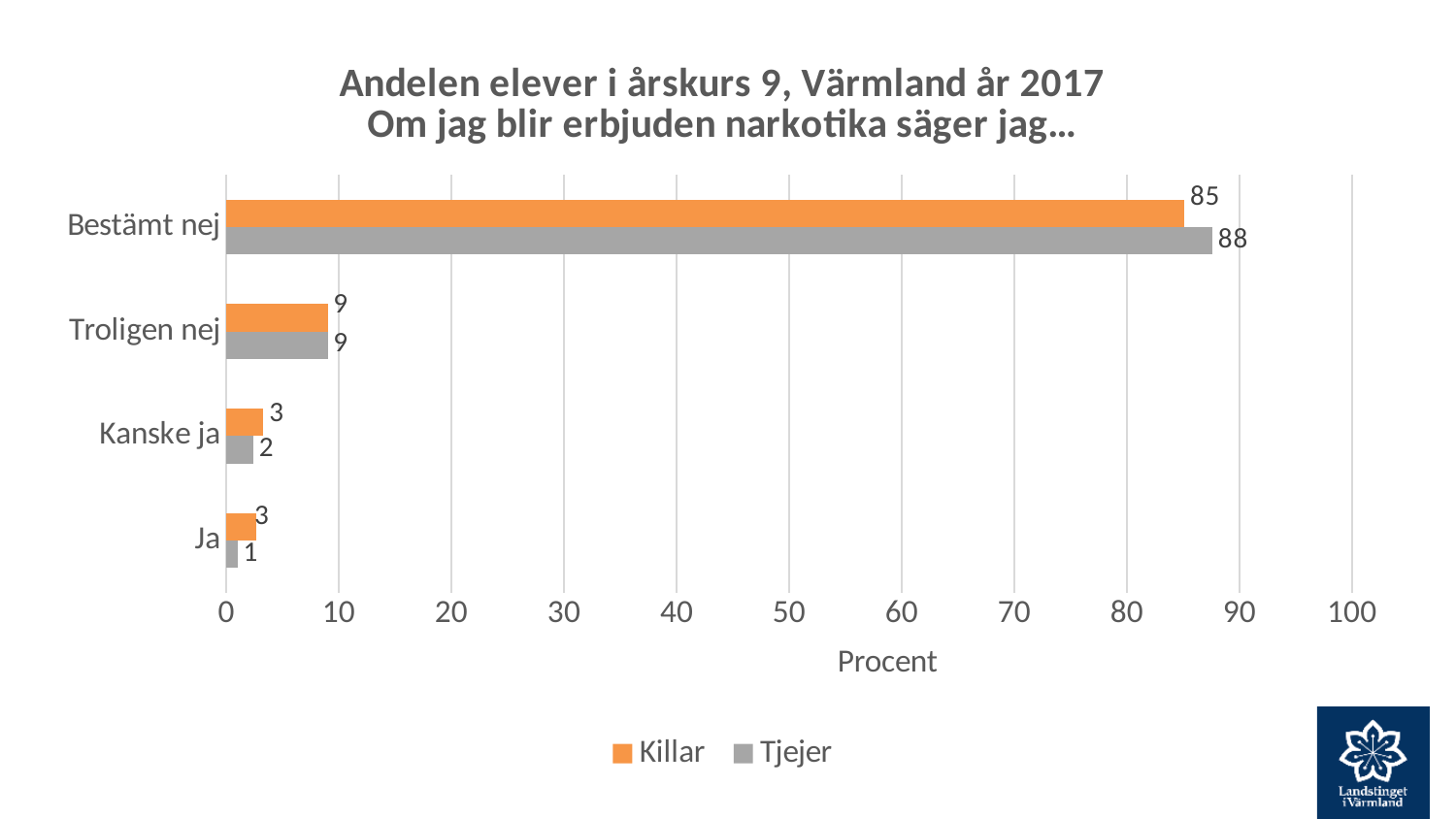
Which category has the highest value for Tjejer? Bestämt nej What is the value for Killar in the Kanske ja category? 3 What is the difference between the Tjejer and Killar values for Bestämt nej? 3 Is the value for Killar in Bestämt nej greater or less than 80? greater What is the value for Tjejer in the Ja category? 1 How many categories are shown on the chart? 4 What is the value for Tjejer in the Bestämt nej category? 88 Which category has the lowest value for Tjejer? Ja Which is larger for Kanske ja, the Killar value or the Tjejer value? Killar How many series does the legend list? 2 What kind of chart is shown on the slide? Bar chart What is the value for Killar in the Bestämt nej category? 85